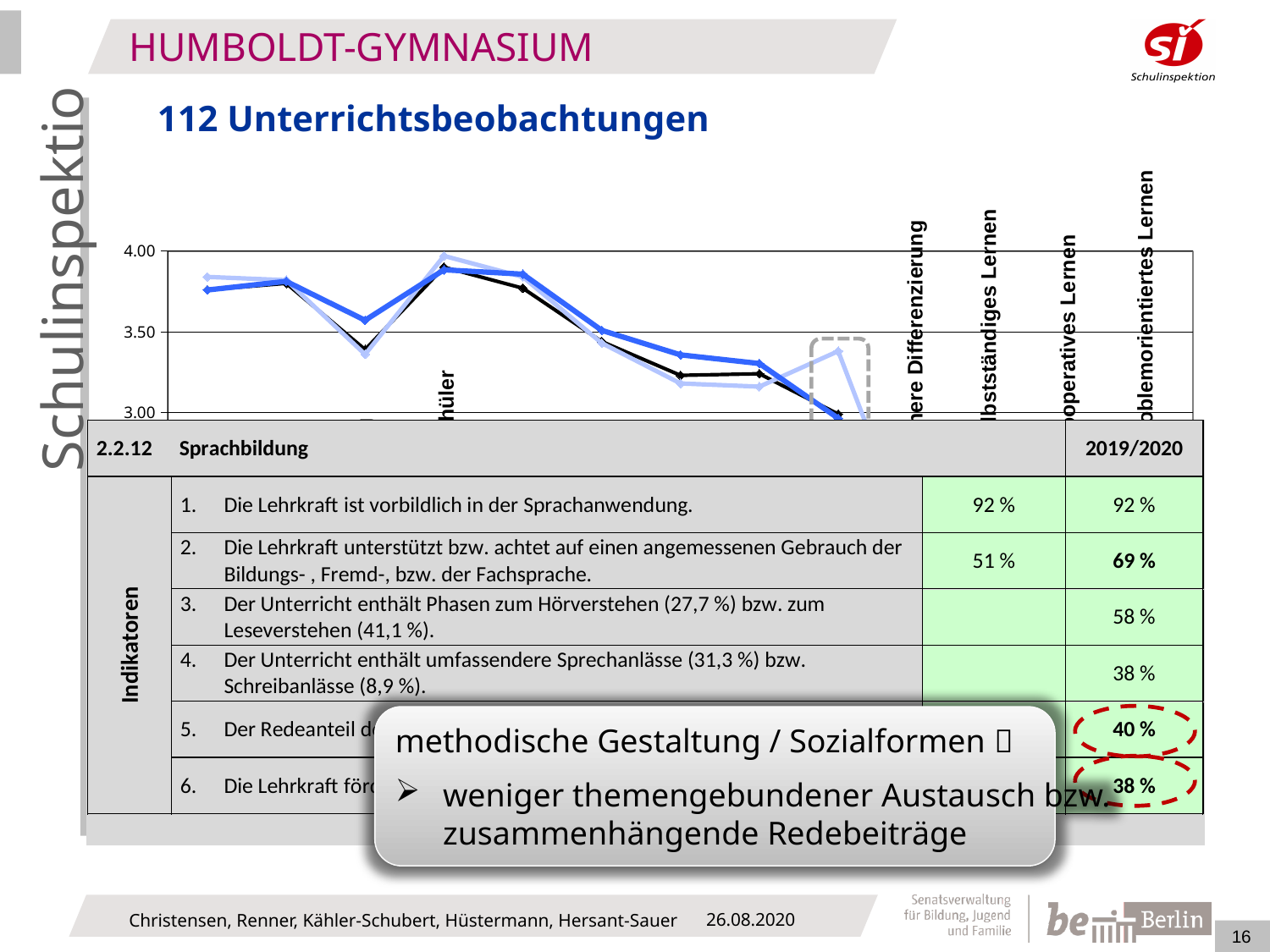
How many lines are plotted on the chart? 3 What is the highest tick value shown on the chart's y axis? 4.00 Are the values at the leftmost point of the lines greater or less than 3.50? greater What kind of chart is shown on the slide? line chart What is the lowest tick value shown on the chart's y axis? 3.00 Do the plotted values generally rise or fall from left to right along the x axis? fall